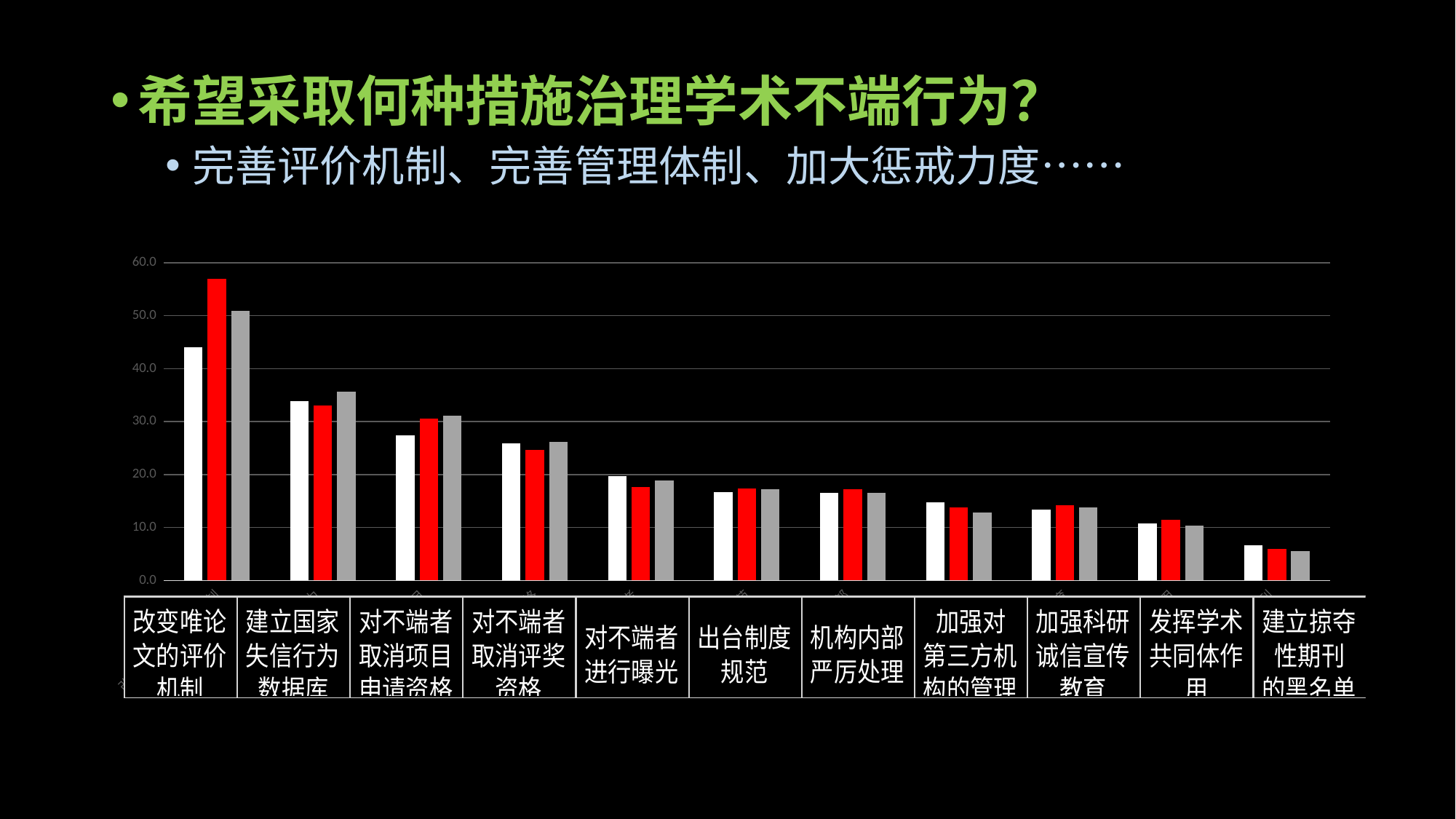
Which category has the tallest bar in the chart? 改变唯论文的评价机制 Is the value of the red bar for 对不端者进行曝光 greater or less than 20? less Do the bar values generally rise or fall from left to right along the x axis? fall How many categories are shown along the x axis of the chart? 11 Which is larger: the red bar for 改变唯论文的评价机制 or the red bar for 建立国家失信行为数据库? 改变唯论文的评价机制 Is the value of the gray bar for 建立掠夺性期刊的黑名单 greater or less than 10? less Is the value of the white bar for 改变唯论文的评价机制 greater or less than 40? greater How many bars are plotted for each category in the chart? 3 What kind of chart is shown on the slide? bar chart Which category has the shortest bars in the chart? 建立掠夺性期刊的黑名单